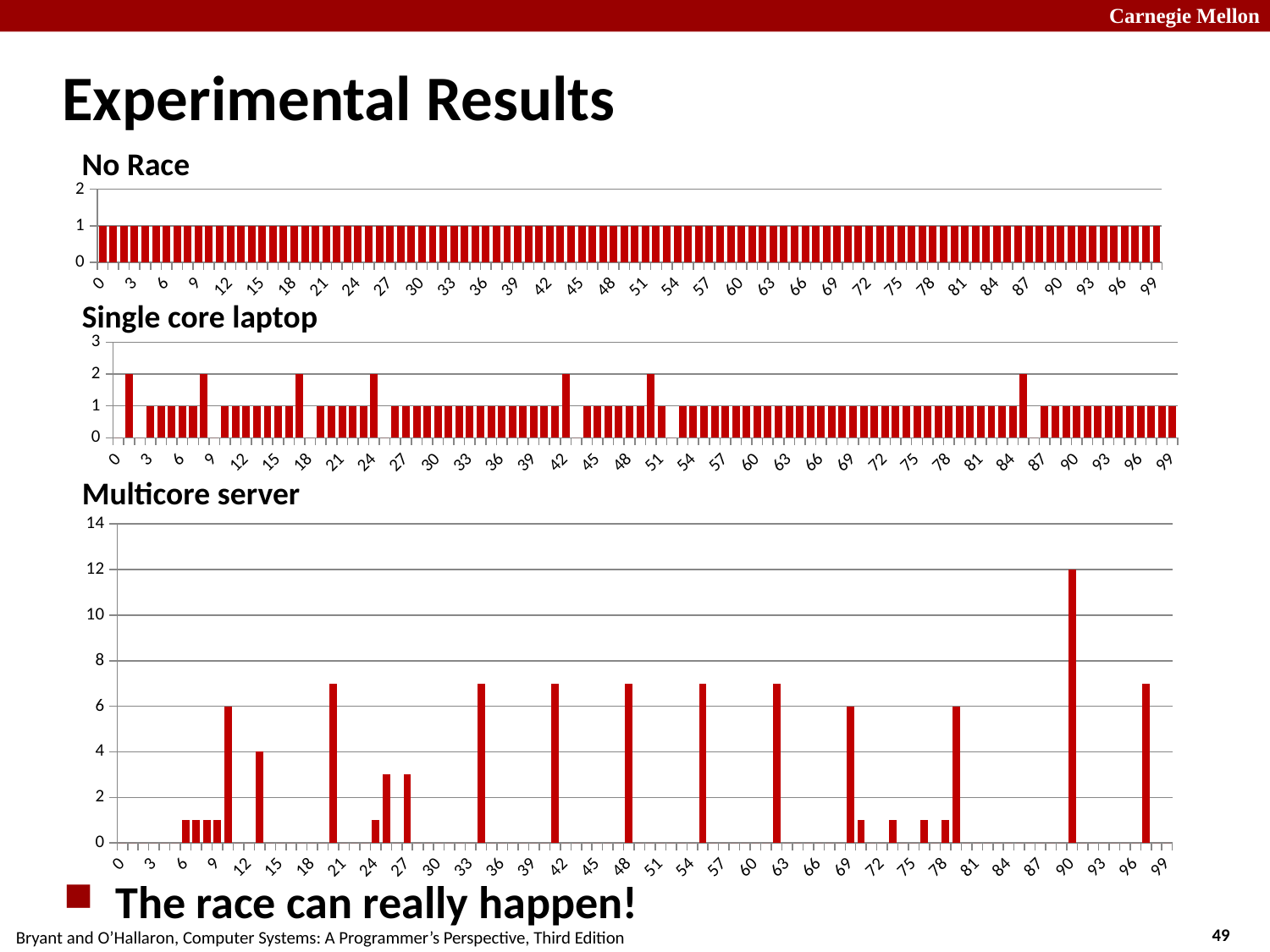
What kind of chart is the "Multicore server" chart? bar chart What is the title of the topmost chart on the slide? No Race Which of the three charts contains the tallest bar? Multicore server In the "Single core laptop" chart, is any bar greater or less than 3? less What is the highest value shown on the y axis of the "Multicore server" chart? 14 In the "No Race" chart, what value does every bar reach? 1 In the "Multicore server" chart, what is the value at x = 0? 0 In the "No Race" chart, is the value of the bar at x = 0 greater or less than 2? less In the "Multicore server" chart, is the tallest bar greater or less than 10? greater In the "Multicore server" chart, what is the value of the tallest bar? 12 How many charts are shown on the slide? 3 In the "Single core laptop" chart, what is the highest value any bar reaches? 2